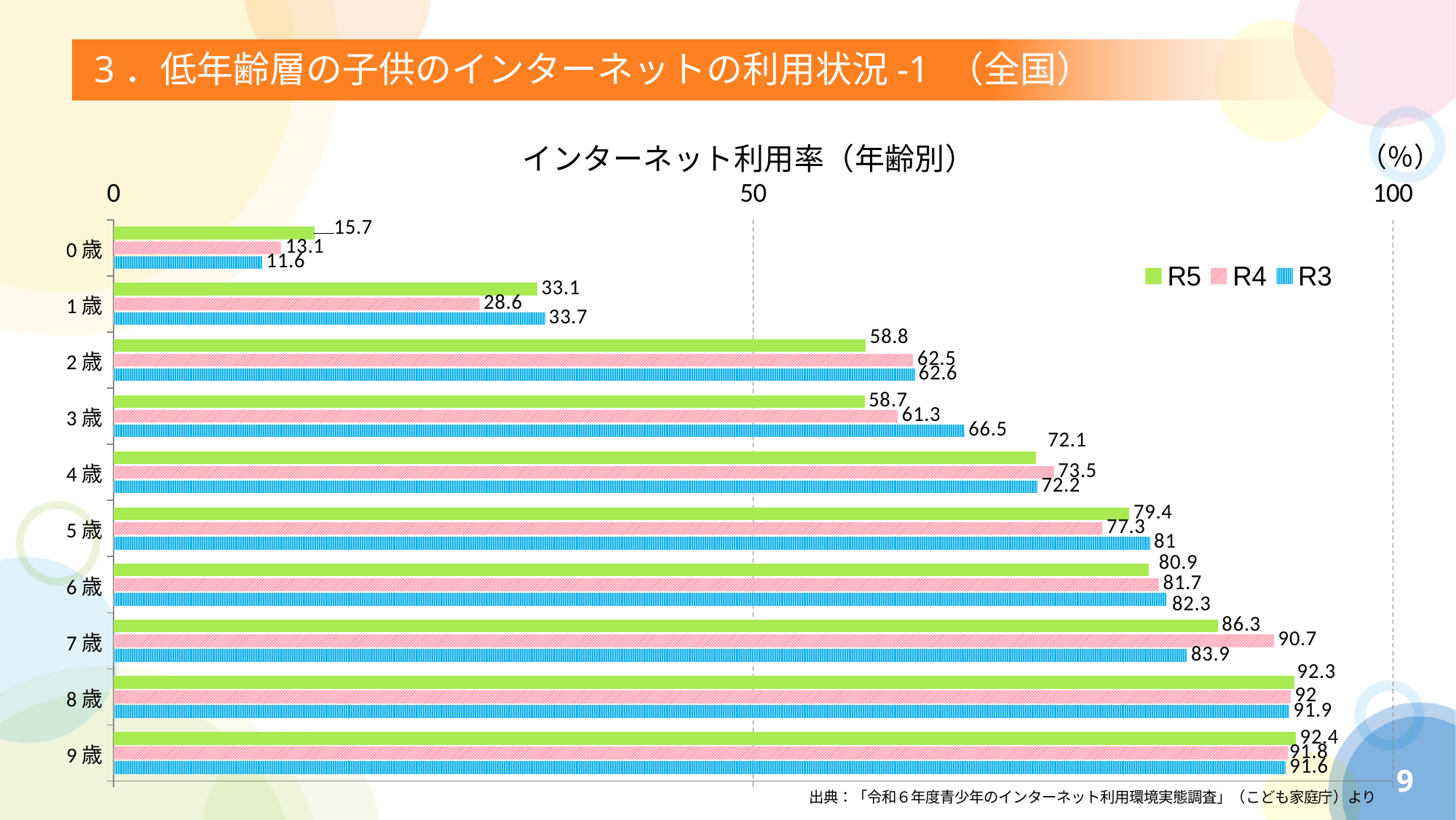
How many age categories are shown on the chart? 10 How many series does the legend list? 3 What is the title of the chart? インターネット利用率（年齢別） What is the difference between the R4 and R3 values for 7歳? 6.8 What is the R4 value for 7歳? 90.7 What is the R5 value for 0歳? 15.7 Which age category has the lowest R3 value? 0歳 For 1歳, which is larger, the R5 value or the R3 value? R3 Which age category has the highest R5 value? 9歳 What kind of chart is shown on the slide? bar chart What is the R3 value for 3歳? 66.5 Is the R5 value for 2歳 greater or less than 50? greater